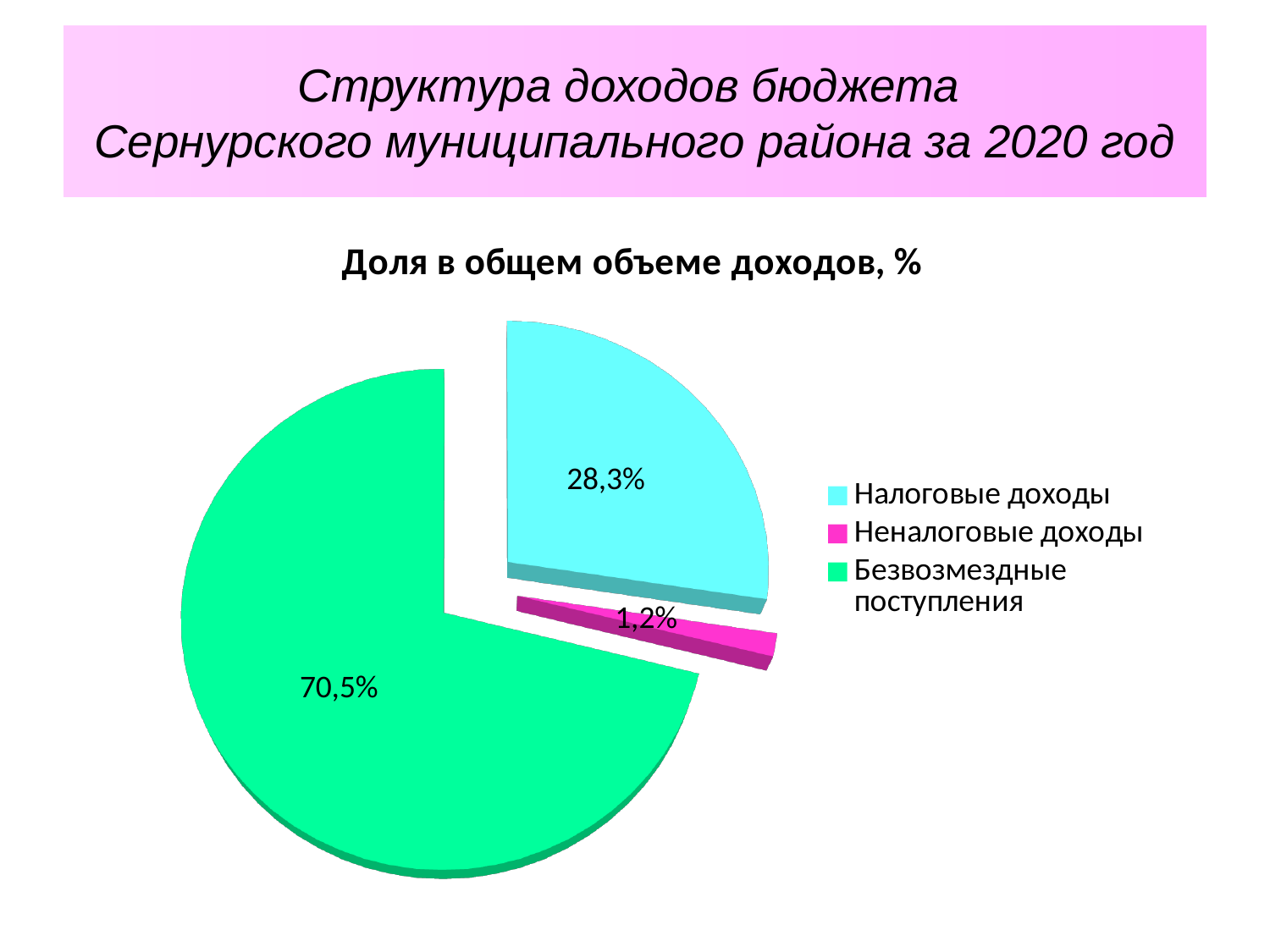
How many slices does the pie chart have? 3 What kind of chart is shown on the slide? pie chart How many entries does the legend list? 3 Which is larger: Налоговые доходы or Неналоговые доходы? Налоговые доходы What share of the pie is Налоговые доходы? 28,3% Which category has the largest share of the pie? Безвозмездные поступления What is the chart's title? Доля в общем объеме доходов, % What share of the pie is Безвозмездные поступления? 70,5% What colour is the slice for Неналоговые доходы? pink What share of the pie is Неналоговые доходы? 1,2% Which category has the smallest share of the pie? Неналоговые доходы What is the difference between the shares of Безвозмездные поступления and Налоговые доходы? 42,2%